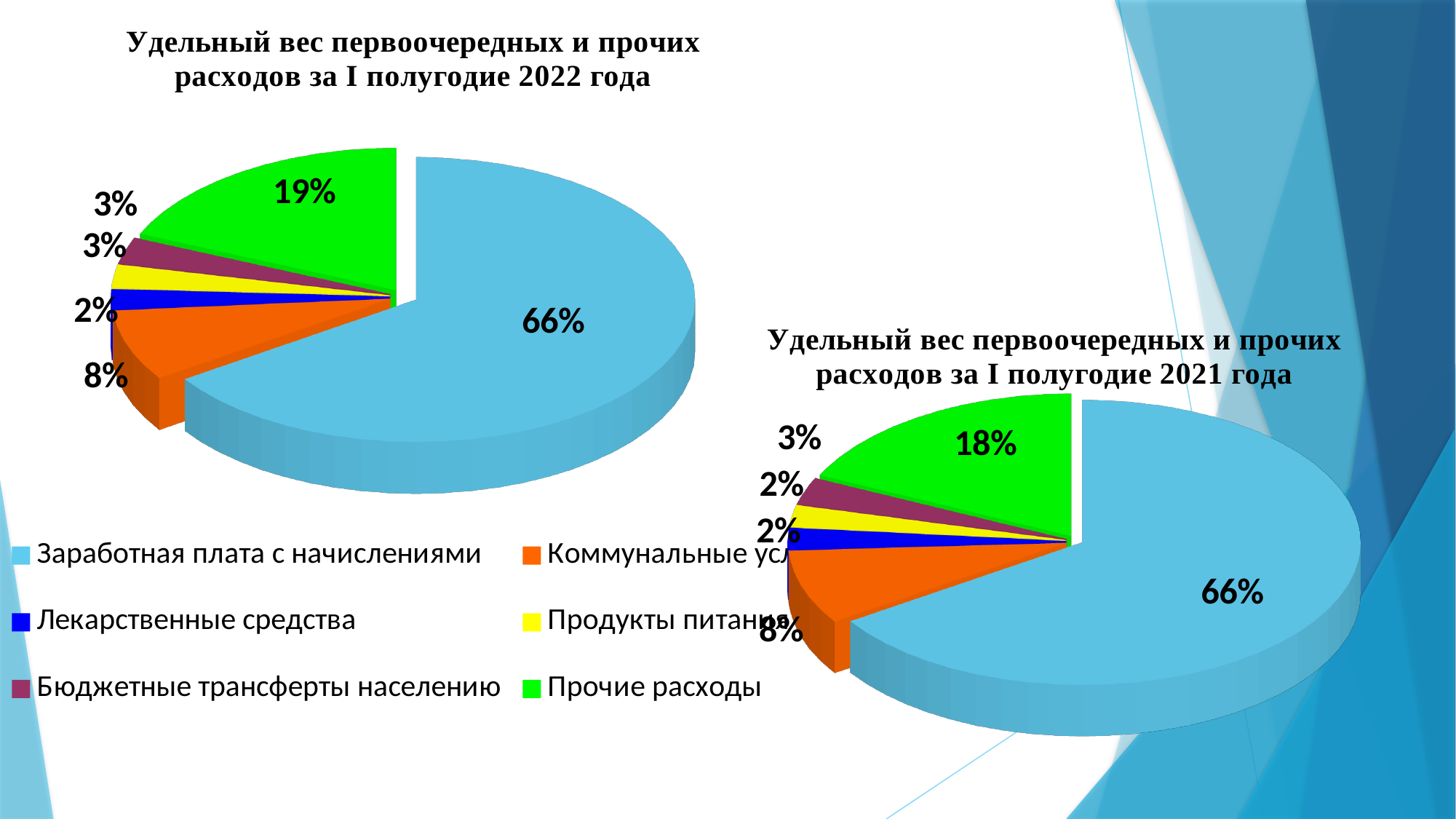
In the 2022 chart (left), what share is shown for Заработная плата с начислениями? 66% How many slices does the 2022 chart (left) have? 6 In the 2021 chart (right), what share is shown for Бюджетные трансферты населению? 3% What type of chart is used on this slide? Pie chart In the 2022 chart (left), which category has the largest slice? Заработная плата с начислениями In the chart titled "Удельный вес первоочередных и прочих расходов за I полугодие 2022 года", what share is shown for Прочие расходы? 19% Is the share of Прочие расходы larger in the 2022 chart or the 2021 chart? 2022 chart In the chart titled "Удельный вес первоочередных и прочих расходов за I полугодие 2021 года", what share is shown for Прочие расходы? 18% How many categories does the legend list? 6 In the 2022 chart (left), which category has the smallest slice? Лекарственные средства What colour represents Прочие расходы in the charts? Green By how many percentage points does the share of Прочие расходы in the 2022 chart exceed that in the 2021 chart? 1 percentage point